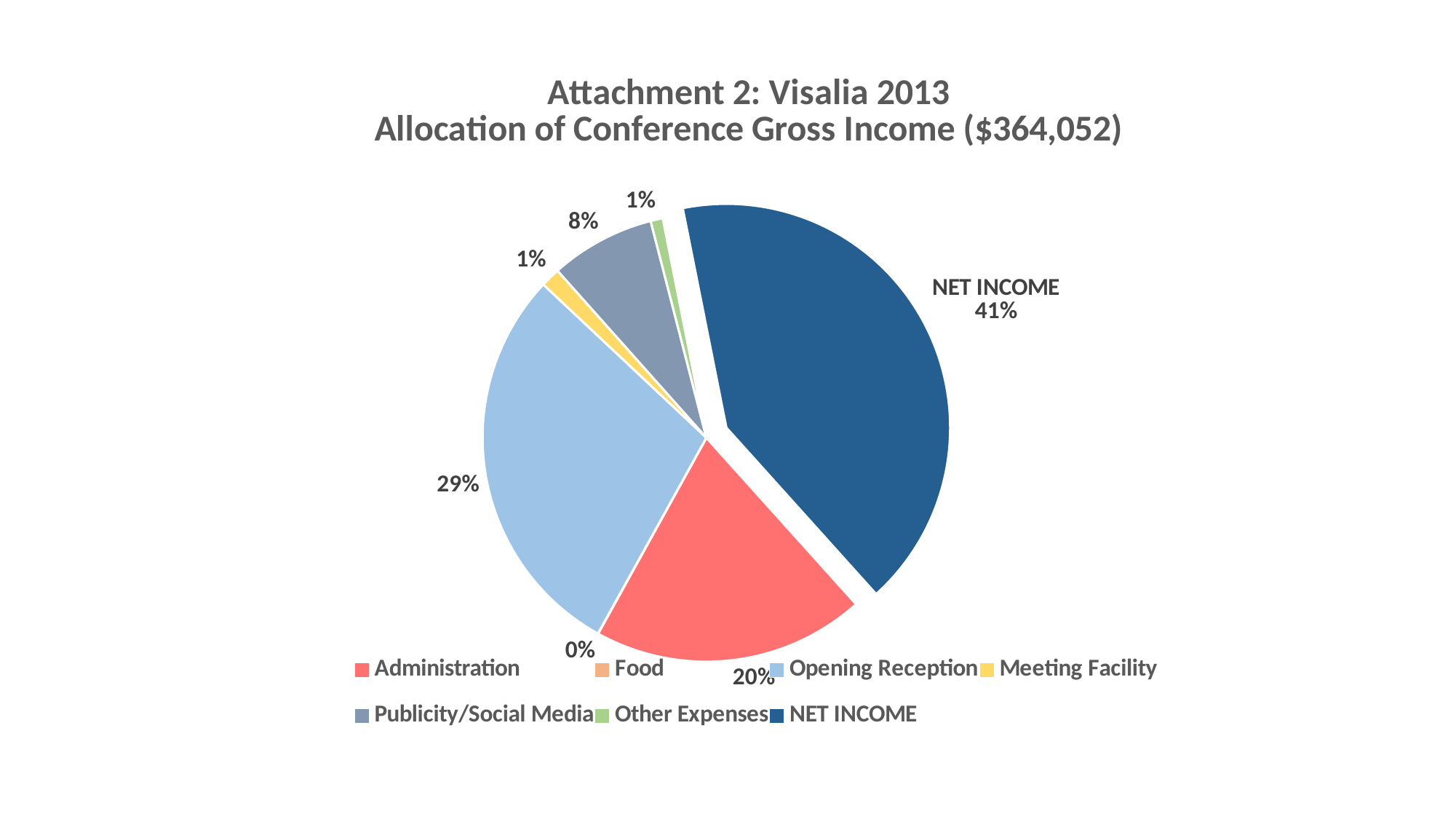
What kind of chart is shown on the slide? Pie chart How many categories does the legend list? 7 What is the difference in percentage points between NET INCOME and Opening Reception? 12 Which is larger, the share for Administration or the share for Publicity/Social Media? Administration What total gross income amount is stated in the chart title? $364,052 What percentage is shown for Food? 0% What percentage is shown for Administration? 20% Which category has the largest slice of the pie? NET INCOME What percentage is shown for Opening Reception? 29% What share of the pie does NET INCOME represent? 41% What percentage is shown for Publicity/Social Media? 8% Which category has the smallest share of the pie? Food